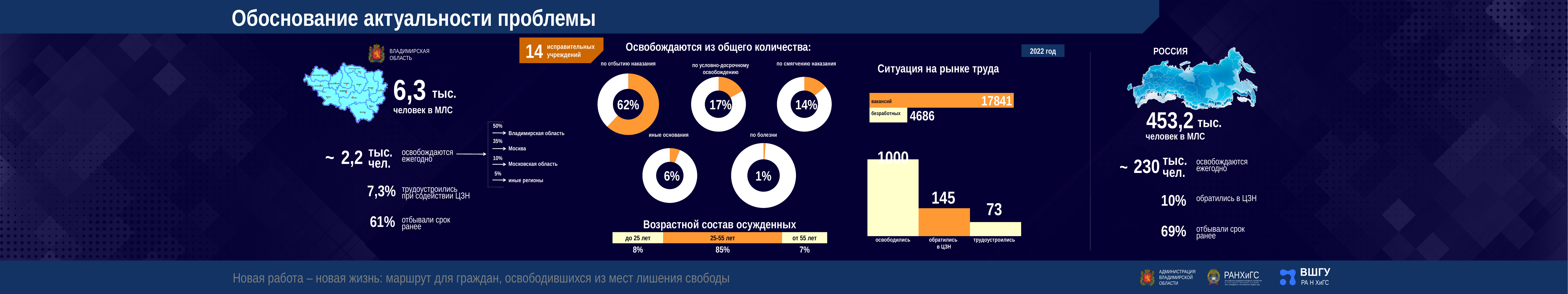
In the 'Ситуация на рынке труда' horizontal bar chart, what is the difference between 'вакансий' and 'безработных'? 13155 In the 'Освобождаются из общего количества' donut charts, which category has the lowest value? по болезни In the vertical bar chart below 'Ситуация на рынке труда', do the values rise or fall from left to right? fall In the vertical bar chart below 'Ситуация на рынке труда', what is the value for 'трудоустроились'? 73 In the 'Возрастной состав осужденных' stacked bar, what is the share for '25-55 лет'? 85% In the vertical bar chart below 'Ситуация на рынке труда', which category has the lowest value? трудоустроились In the 'Ситуация на рынке труда' horizontal bar chart, what is the value for 'вакансий'? 17841 In the vertical bar chart below 'Ситуация на рынке труда', how many categories are shown? 3 In the 'Ситуация на рынке труда' horizontal bar chart, what is the value for 'безработных'? 4686 In the vertical bar chart below 'Ситуация на рынке труда', what is the difference between 'обратились в ЦЗН' and 'трудоустроились'? 72 In the 'Освобождаются из общего количества' donut charts, what is the value for 'по отбытию наказания'? 62% In the vertical bar chart below 'Ситуация на рынке труда', what is the value for 'освободились'? 1000